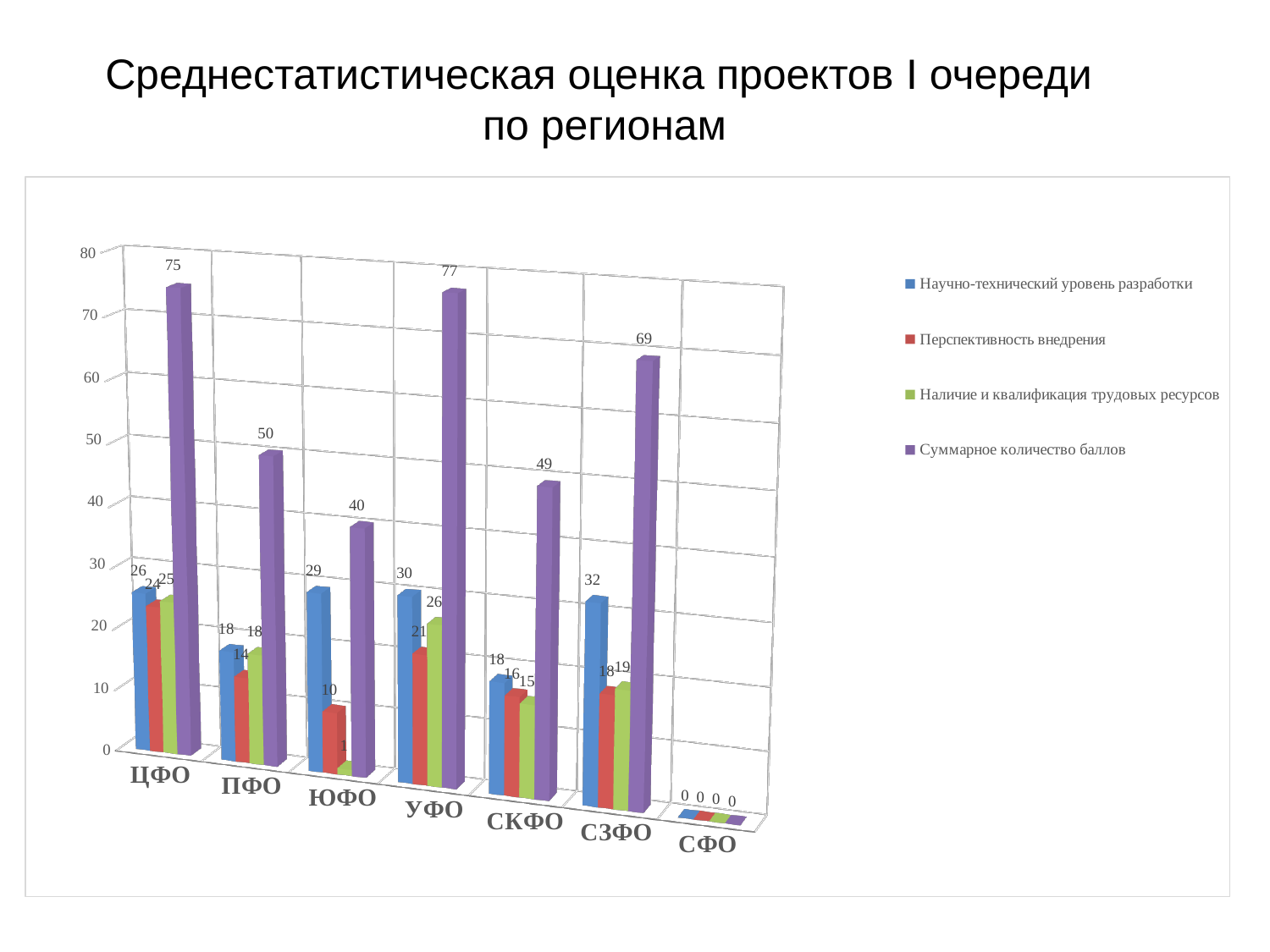
How many series does the legend list? 4 How many regions are shown on the x axis? 7 Which is larger: the Научно-технический уровень разработки for ЮФО or for УФО? УФО What is the title of the slide? Среднестатистическая оценка проектов I очереди по регионам Which region has the lowest Суммарное количество баллов? СФО Which region has the highest Суммарное количество баллов? УФО What kind of chart is shown on the slide? Bar chart What is the difference between the Суммарное количество баллов for УФО and for ПФО? 27 What is the value of Наличие и квалификация трудовых ресурсов for УФО? 26 What is the value of Суммарное количество баллов for ЦФО? 75 What is the value of Научно-технический уровень разработки for СЗФО? 32 What is the value of Перспективность внедрения for ЮФО? 10